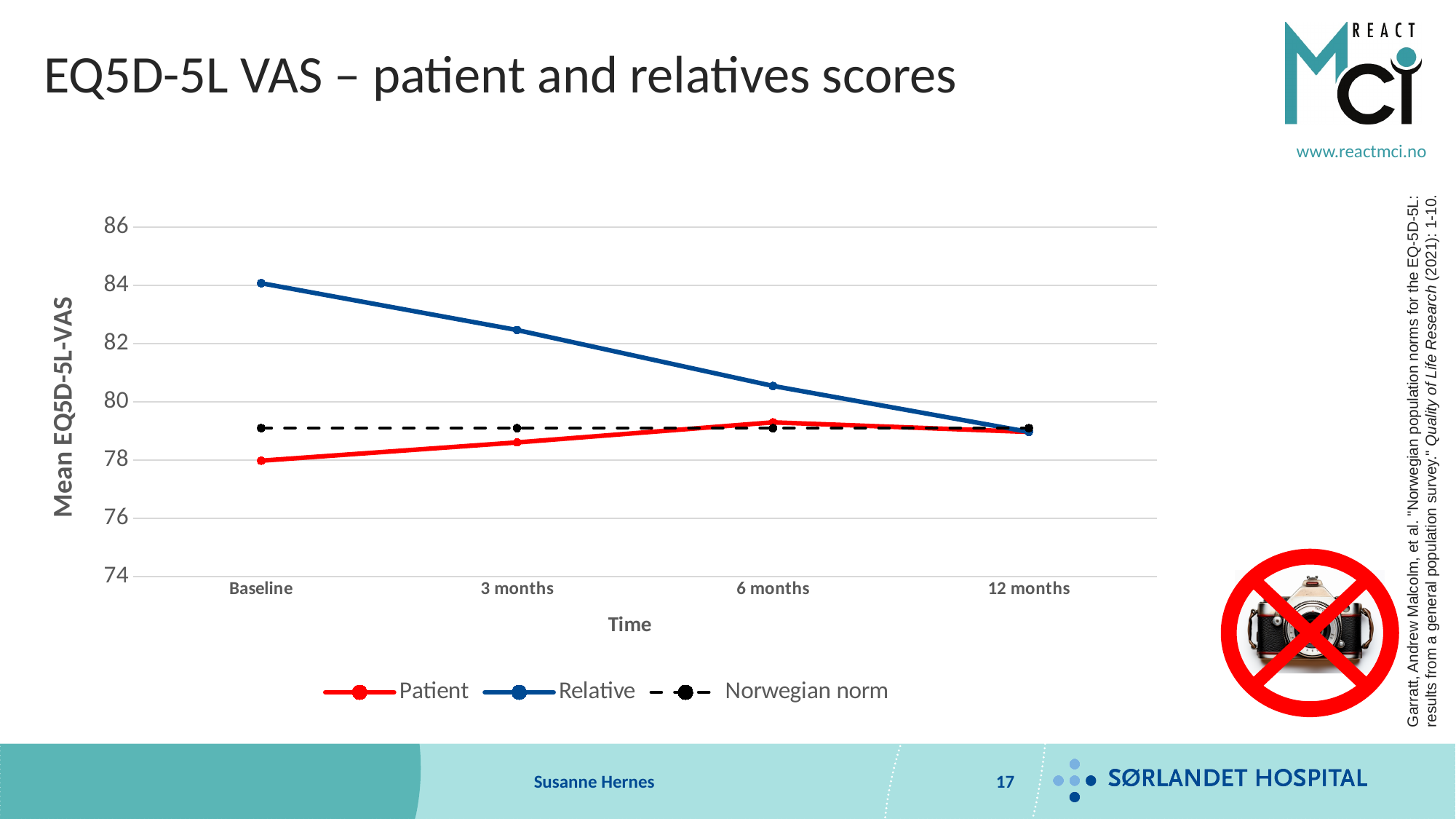
Is the Patient score at Baseline greater or less than 80? less What kind of chart is shown on the slide? line chart Does the Relative score rise or fall from Baseline to 12 months? fall At which time point is the Patient score lowest? Baseline Is the Relative score at Baseline greater or less than 82? greater Is the Relative score at 6 months greater or less than 80? greater At Baseline, which is higher, the Patient score or the Relative score? Relative Which series does the dashed black line represent? Norwegian norm At which time point is the Relative score highest? Baseline What is the label of the y axis? Mean EQ5D-5L-VAS How many time points are plotted along the x axis? 4 How many series does the legend list? 3